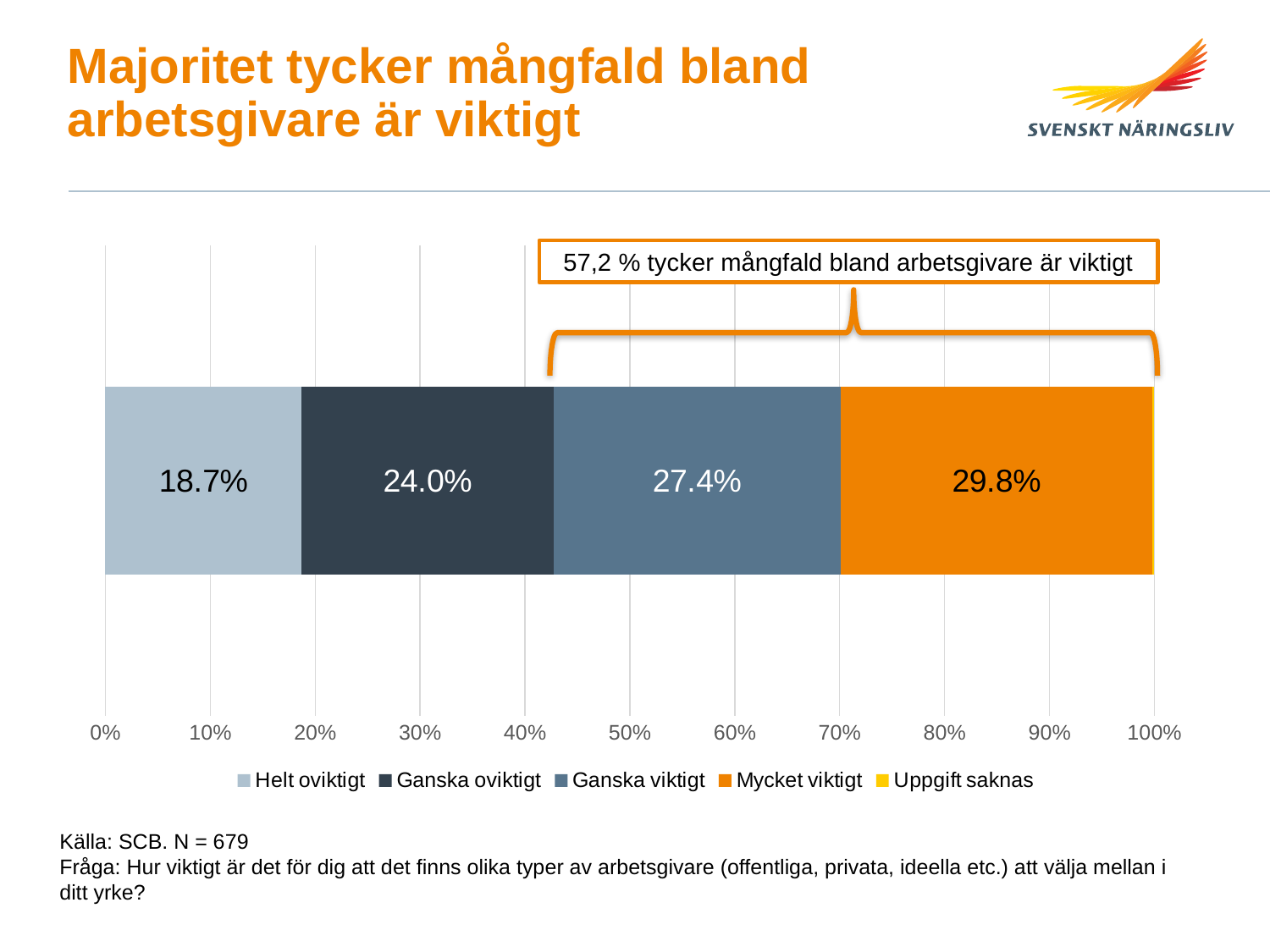
What percentage of respondents answered "Ganska oviktigt"? 24.0% What percentage of respondents answered "Helt oviktigt"? 18.7% What is the combined share of "Ganska viktigt" and "Mycket viktigt"? 57.2% Which response category has the largest share? Mycket viktigt How many series does the legend list? 5 What percentage of respondents answered "Mycket viktigt"? 29.8% Which labelled response category has the smallest share? Helt oviktigt Which is larger, the share for "Ganska viktigt" or the share for "Ganska oviktigt"? Ganska viktigt What kind of chart is shown on the slide? Stacked bar chart What colour is the "Mycket viktigt" segment? Orange What percentage of respondents answered "Ganska viktigt"? 27.4% What is the difference between the "Mycket viktigt" and "Helt oviktigt" shares? 11.1 percentage points